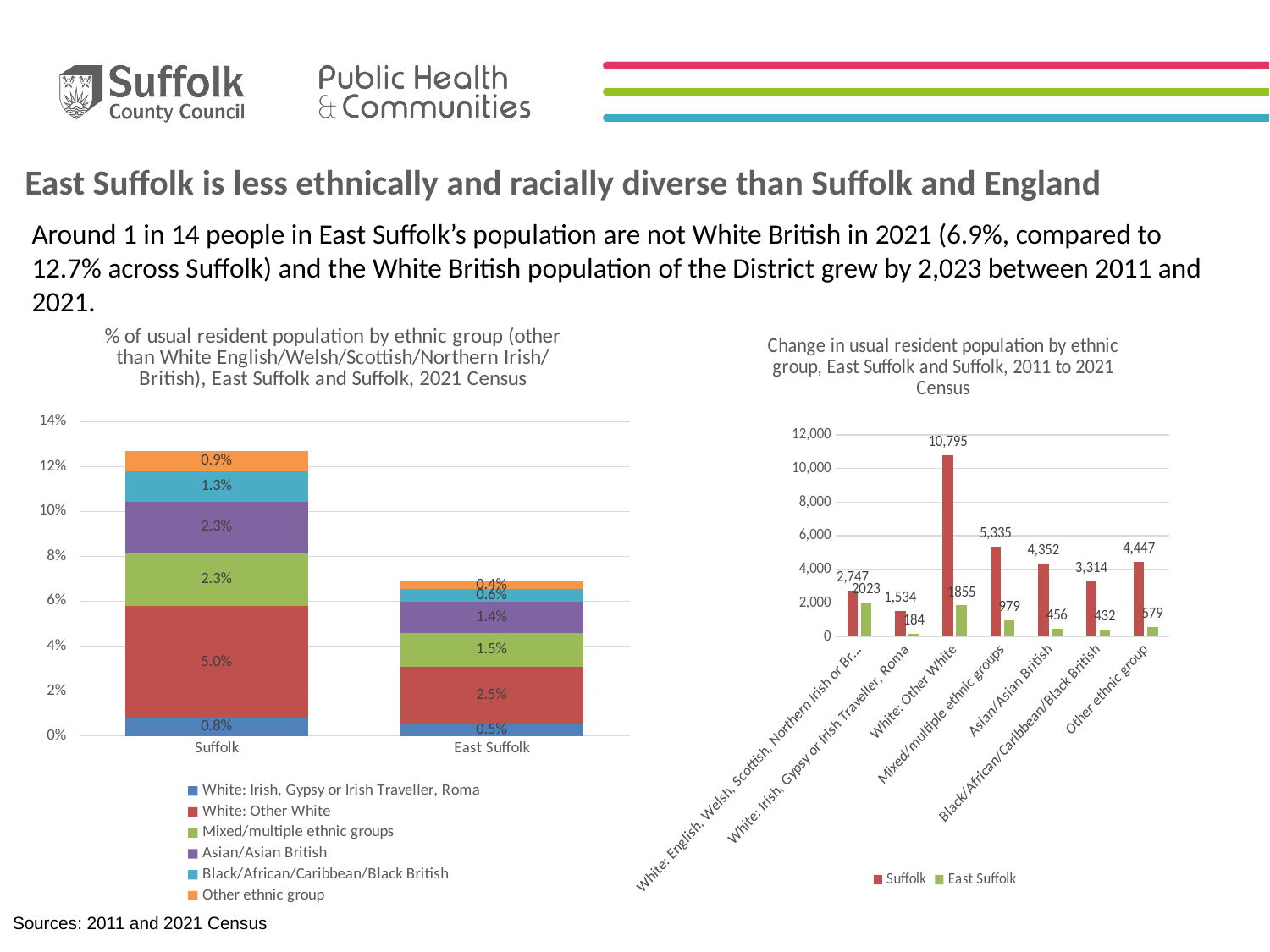
In the right chart, 'Change in usual resident population by ethnic group', what is the Suffolk value for 'White: Other White'? 10,795 What kind of chart is the left chart, '% of usual resident population by ethnic group'? Stacked bar chart In the right chart, which is larger for Suffolk: 'Asian/Asian British' or 'Black/African/Caribbean/Black British'? Asian/Asian British In the right chart, which ethnic group has the highest Suffolk value? White: Other White In the right chart, which ethnic group has the lowest East Suffolk value? White: Irish, Gypsy or Irish Traveller, Roma In the left chart, what is the difference between the 'White: Other White' values for Suffolk and East Suffolk? 2.5 percentage points In the left chart, what is the total of the East Suffolk stacked bar? 6.9% In the right chart, what is the difference between the Suffolk and East Suffolk values for 'Mixed/multiple ethnic groups'? 4,356 In the left chart, what is the value for 'Asian/Asian British' for East Suffolk? 1.4% How many ethnic group categories are shown on the x axis of the right chart? 7 In the left chart, what is the value for 'White: Other White' for Suffolk? 5.0% How many series does the legend of the left chart list? 6